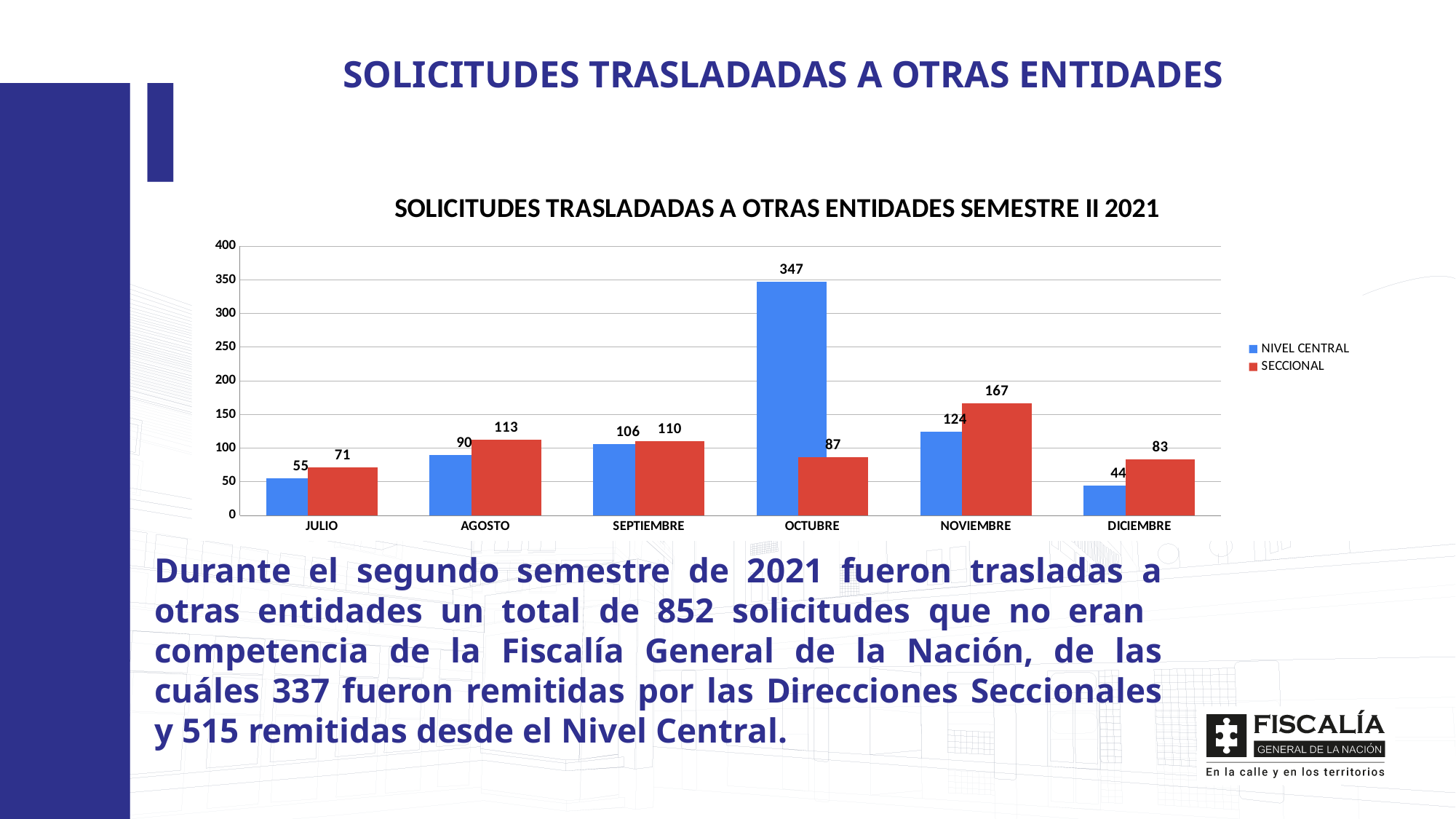
What kind of chart is shown? bar chart Which month has the lowest SECCIONAL value? JULIO Which month has the highest NIVEL CENTRAL value? OCTUBRE What is the NIVEL CENTRAL value for JULIO? 55 How many months are shown on the x axis? 6 What is the SECCIONAL value for NOVIEMBRE? 167 Is the SECCIONAL value for DICIEMBRE greater or less than 100? less What is the difference between the NIVEL CENTRAL and SECCIONAL values in OCTUBRE? 260 What is the NIVEL CENTRAL value for OCTUBRE? 347 In NOVIEMBRE, which is larger, NIVEL CENTRAL or SECCIONAL? SECCIONAL How many series does the legend list? 2 What is the title of the chart? SOLICITUDES TRASLADADAS A OTRAS ENTIDADES SEMESTRE II 2021